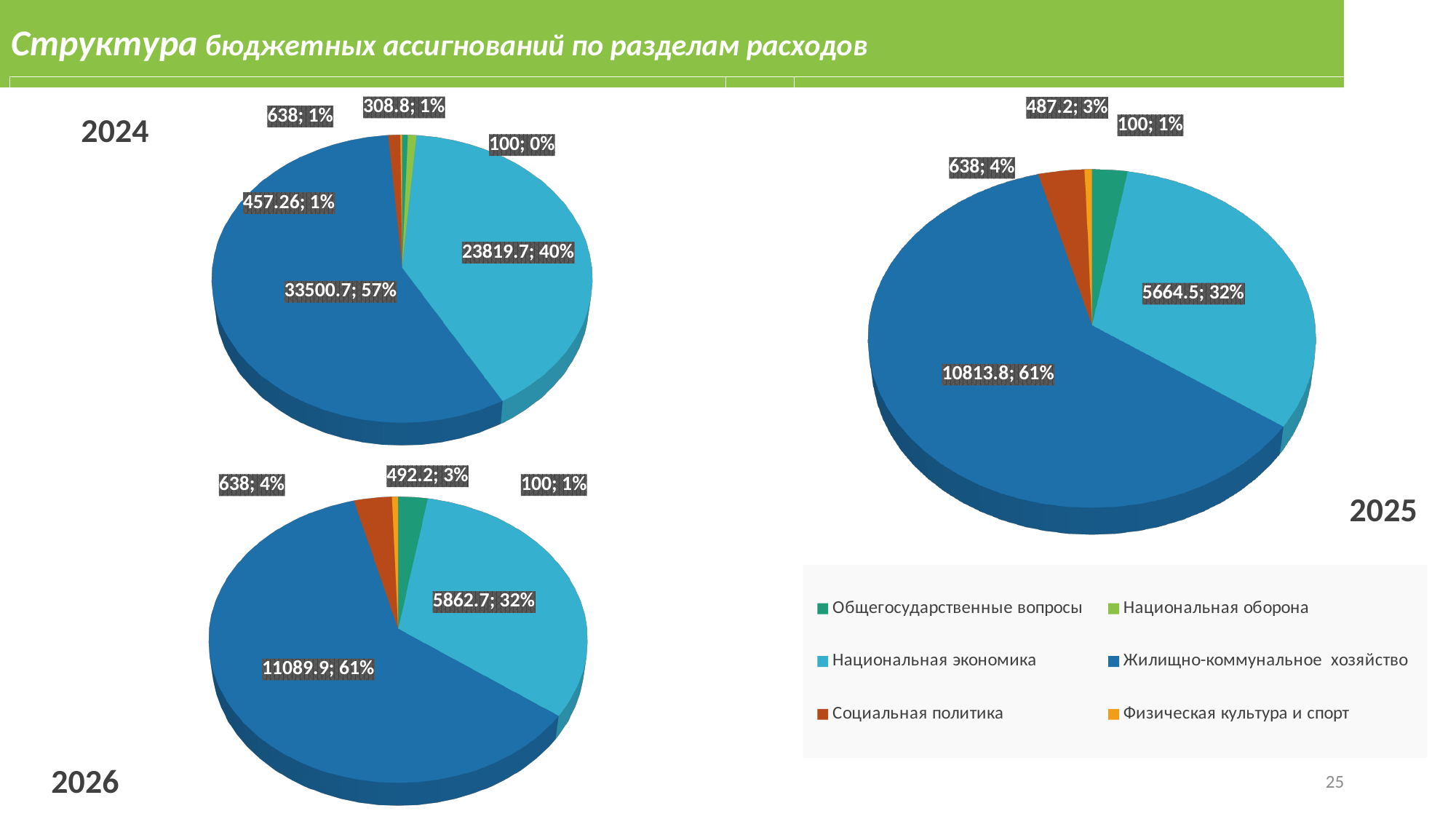
Which is larger: the value for Жилищно-коммунальное хозяйство in the 2025 pie chart or in the 2026 pie chart? 2026 In the 2026 pie chart, what is the value for Жилищно-коммунальное хозяйство? 11089.9 How many pie charts are on the slide? 3 How many categories does the legend list? 6 What is the difference between the value for Национальная экономика in the 2026 pie chart and in the 2025 pie chart? 198.2 In the 2025 pie chart, what share does Жилищно-коммунальное хозяйство have? 61% In the 2024 pie chart, what share does Национальная экономика have? 40% In the 2024 pie chart, what is the value for Жилищно-коммунальное хозяйство? 33500.7 What kind of charts are shown on the slide? Pie charts In the 2026 pie chart, what share does Национальная экономика have? 32% In the 2025 pie chart, what is the value for Национальная экономика? 5664.5 In the 2024 pie chart, which category has the largest slice? Жилищно-коммунальное хозяйство